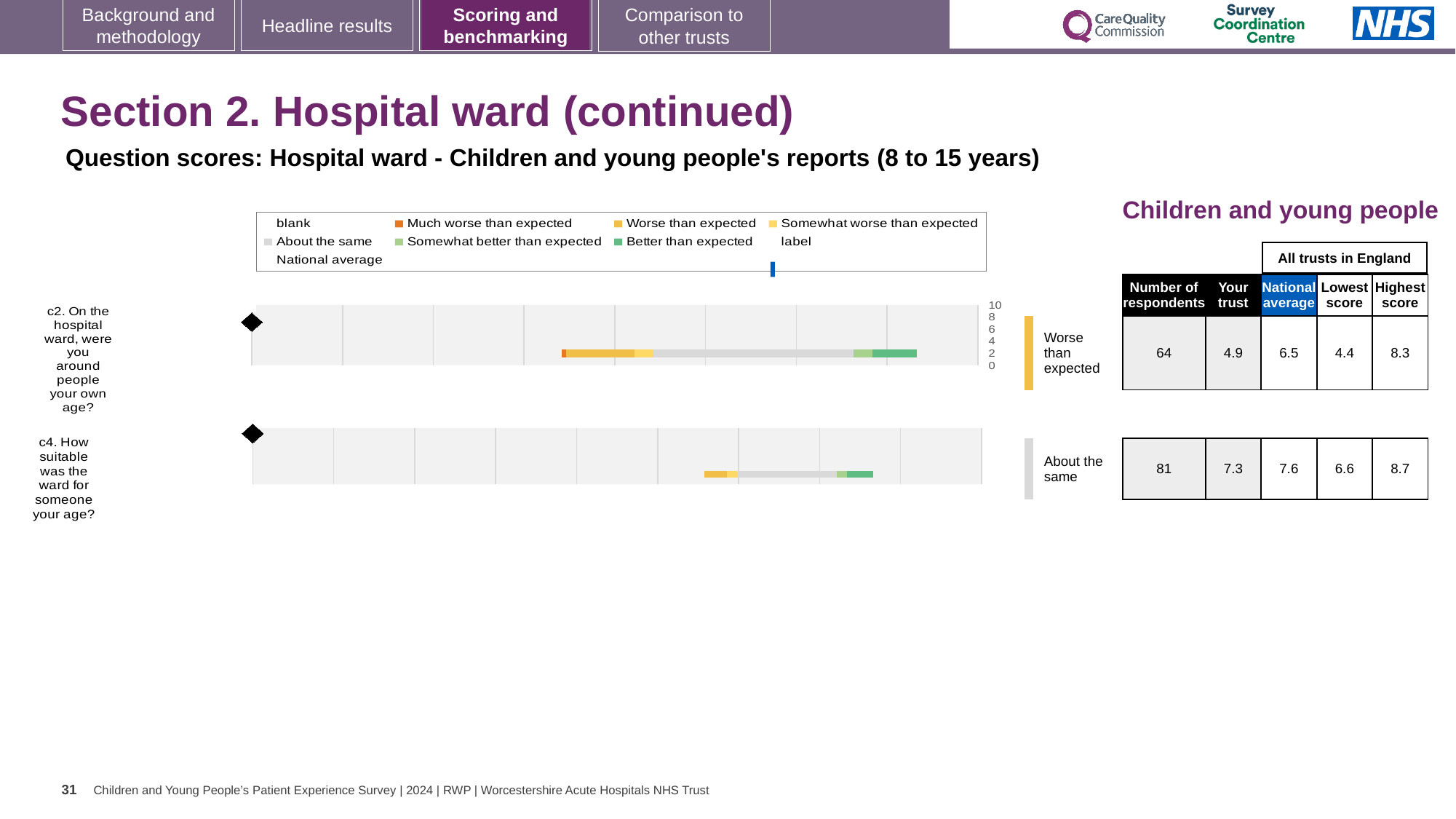
What kind of chart is used to show the question scores for c2 and c4? bar chart What is the national average score for c4 (How suitable was the ward for someone your age?)? 7.6 How much lower is the trust's score than the national average for c2? 1.6 What benchmark category is shown for c2? Worse than expected How many respondents answered question c2? 64 How many questions (categories) are plotted in the chart? 2 What is the lowest score among all trusts in England for c4? 6.6 What benchmark category is shown for c4? About the same Which question has the higher number of respondents? c4 What is the difference between the highest and lowest scores for c4? 2.1 What is the 'Your trust' score for c2 (On the hospital ward, were you around people your own age?)? 4.9 Which question has the higher 'Your trust' score, c2 or c4? c4